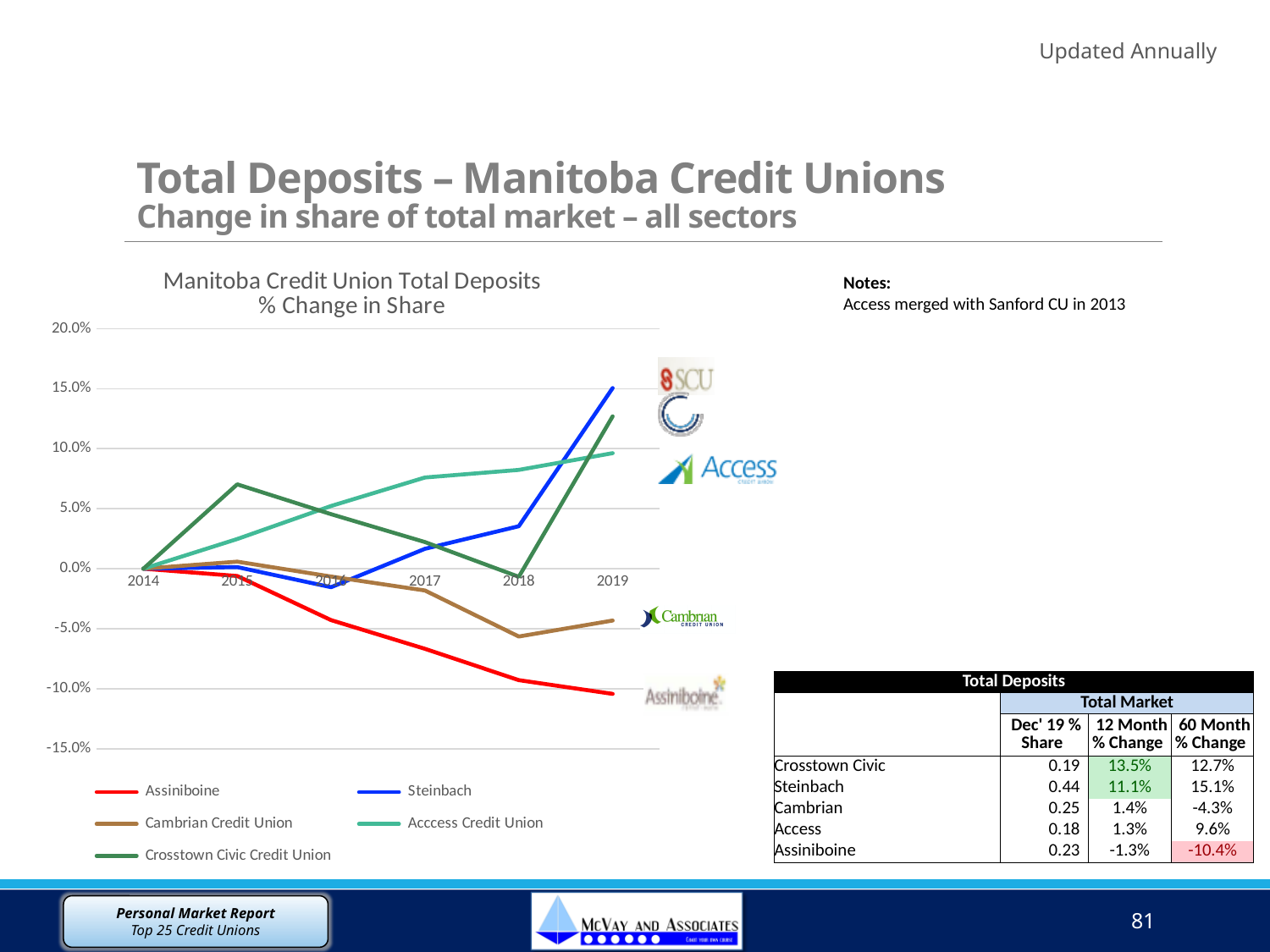
In 2019, which is higher: Acccess Credit Union or Cambrian Credit Union? Acccess Credit Union What kind of chart is shown on the slide? line chart What is the title of the chart? Manitoba Credit Union Total Deposits % Change in Share Which credit union has the highest % change in share in 2019? Steinbach In 2018, which is higher: Acccess Credit Union or Crosstown Civic Credit Union? Acccess Credit Union Is the value for Crosstown Civic Credit Union in 2015 greater or less than 5.0%? greater Is the value for Steinbach in 2019 greater or less than 10.0%? greater Does the Assiniboine line rise or fall from 2014 to 2019? fall How many series does the legend of the chart list? 5 Which credit union has the lowest % change in share in 2019? Assiniboine How many years are shown along the x axis of the chart? 6 Is the value for Assiniboine in 2019 greater or less than -5.0%? less